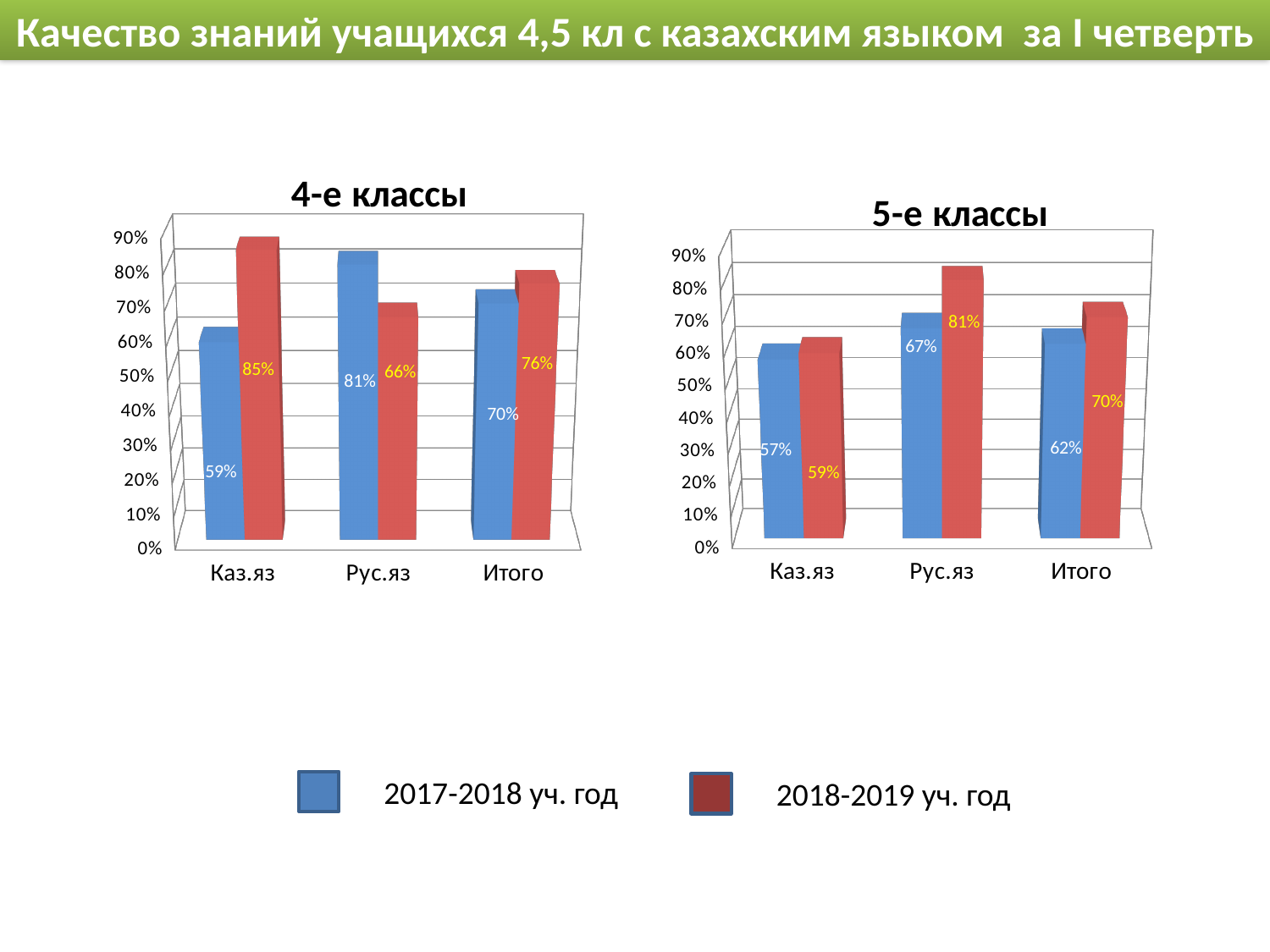
In the "4-е классы" chart, which category has the highest value for 2018-2019 уч. год? Каз.яз In the "4-е классы" chart, what is the difference between the 2018-2019 and 2017-2018 values for Каз.яз? 26% In the "5-е классы" chart, what is the value for Итого in 2017-2018 уч. год? 62% In the "4-е классы" chart, what is the value for Рус.яз in 2018-2019 уч. год? 66% How many categories are shown on the x axis of the "5-е классы" chart? 3 In the "5-е классы" chart, which category has the lowest value for 2017-2018 уч. год? Каз.яз In the "4-е классы" chart, what is the value for Каз.яз in 2017-2018 уч. год? 59% How many series does the legend list? 2 In the "5-е классы" chart, what is the difference between the 2018-2019 and 2017-2018 values for Рус.яз? 14% What type of chart is the "4-е классы" chart? Bar chart In the "4-е классы" chart, which is larger for Рус.яз: the 2017-2018 value or the 2018-2019 value? 2017-2018 уч. год In the "5-е классы" chart, what is the value for Рус.яз in 2018-2019 уч. год? 81%